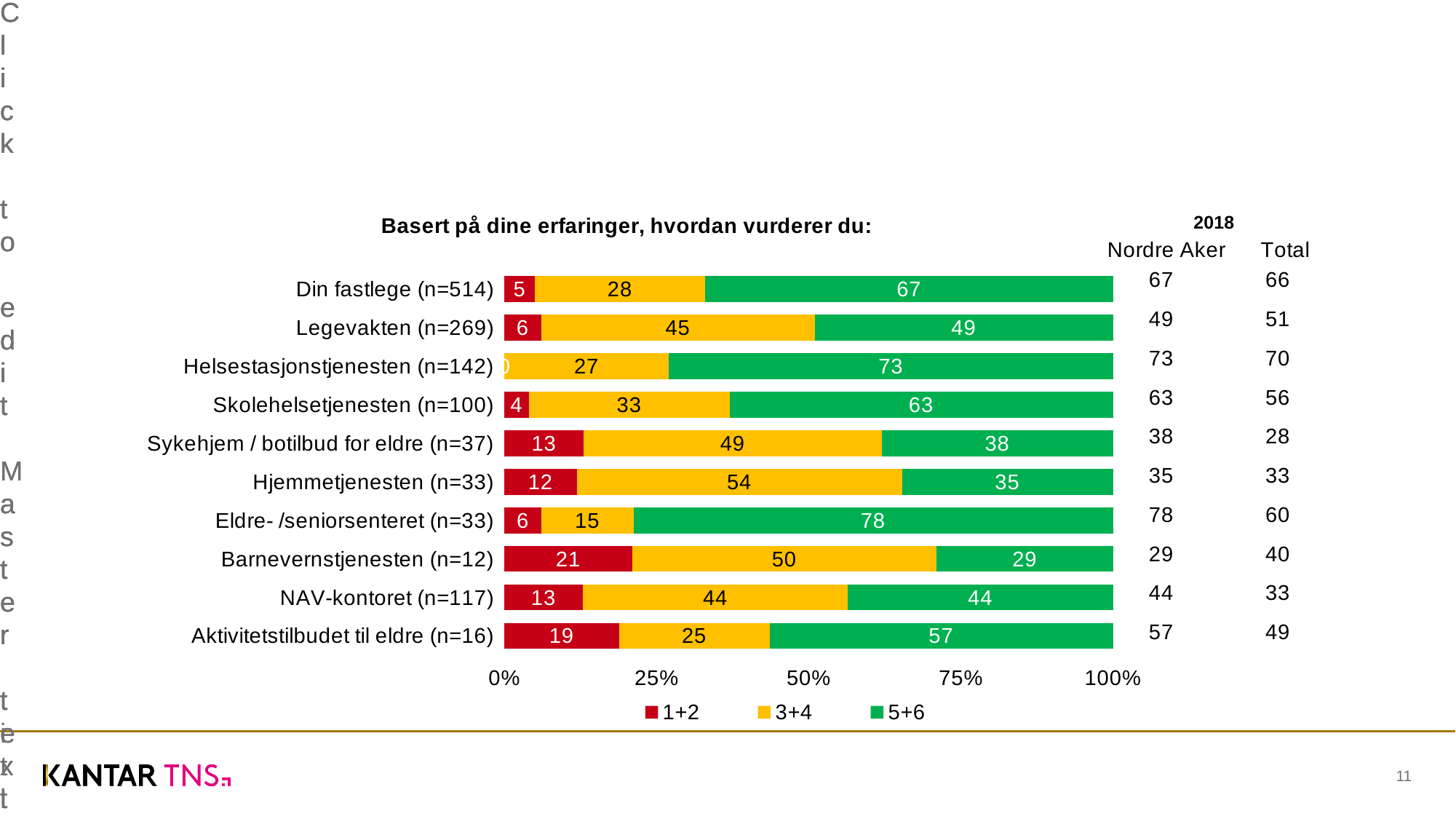
Which has the larger 3+4 value: Sykehjem / botilbud for eldre (n=37) or Hjemmetjenesten (n=33)? Hjemmetjenesten (n=33) What is the 1+2 value for Barnevernstjenesten (n=12)? 21 What kind of chart is shown on the slide? bar chart What is the difference between the 5+6 value for Din fastlege (n=514) and the 5+6 value for Legevakten (n=269)? 18 What is the total of the stacked bar for Aktivitetstilbudet til eldre (n=16)? 101 What is the 5+6 value for Din fastlege (n=514)? 67 How many categories (services) are plotted in the chart? 10 What is the title of the chart? Basert på dine erfaringer, hvordan vurderer du: What is the 3+4 value for Hjemmetjenesten (n=33)? 54 Which category has the lowest 5+6 value? Barnevernstjenesten (n=12) How many series does the legend list? 3 Which category has the highest 5+6 value? Eldre- /seniorsenteret (n=33)